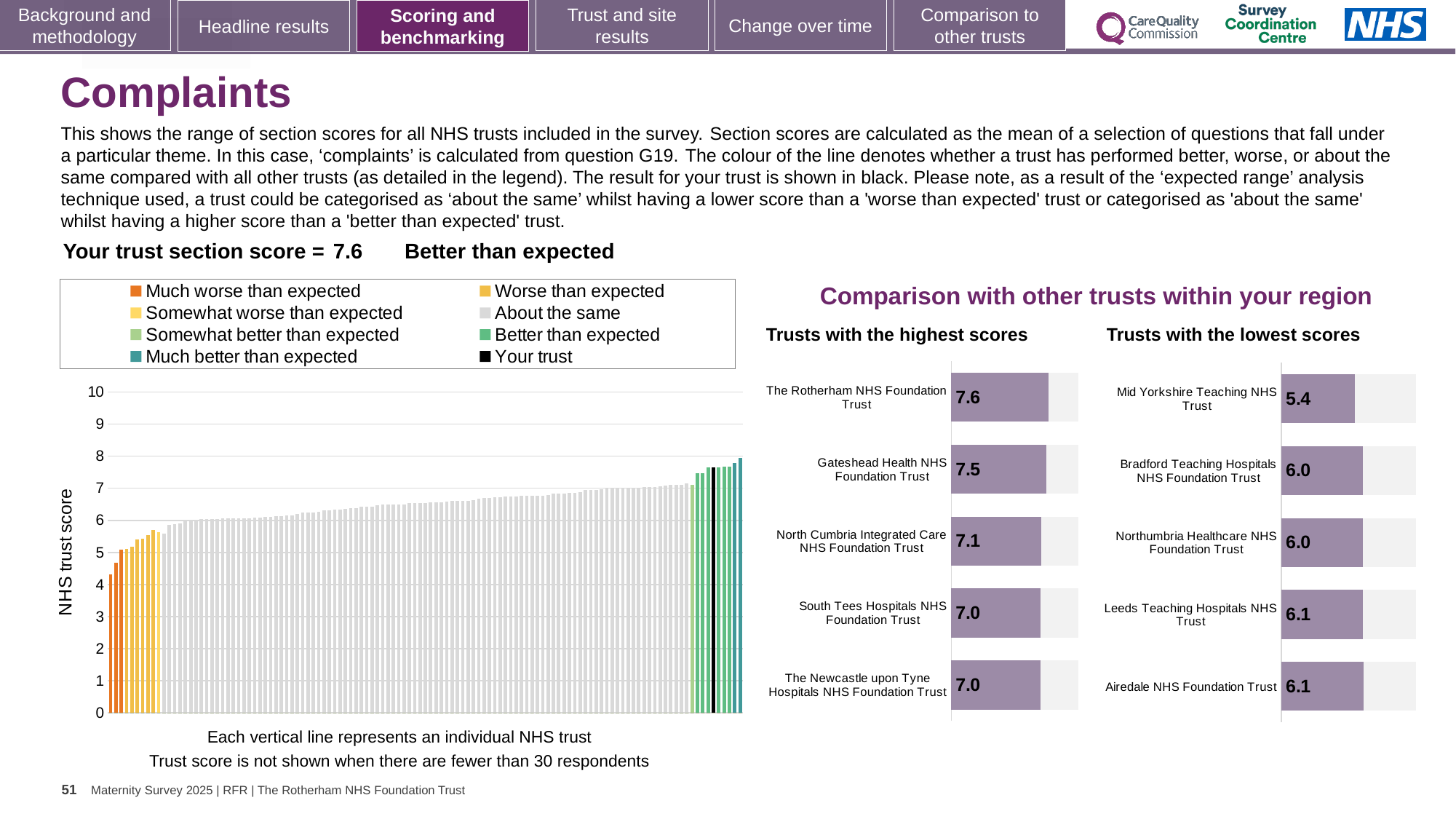
In the NHS trust score chart on the left, what colour is used for 'Your trust'? Black In the 'Trusts with the highest scores' chart, which has the larger score: Gateshead Health NHS Foundation Trust or North Cumbria Integrated Care NHS Foundation Trust? Gateshead Health NHS Foundation Trust In the 'Trusts with the lowest scores' chart, how many trusts are shown? 5 In the 'Trusts with the lowest scores' chart, which trust has the lowest score? Mid Yorkshire Teaching NHS Trust In the 'Trusts with the highest scores' chart, what is the difference between the scores of The Rotherham NHS Foundation Trust and Gateshead Health NHS Foundation Trust? 0.1 How many entries does the legend of the NHS trust score chart on the left list? 8 In the 'Trusts with the highest scores' chart, which trust has the highest score? The Rotherham NHS Foundation Trust In the 'Trusts with the lowest scores' chart, what is the difference between the scores of Airedale NHS Foundation Trust and Mid Yorkshire Teaching NHS Trust? 0.7 In the NHS trust score chart on the left, is the value of the lowest bar greater or less than 5? less In the 'Trusts with the highest scores' chart, what is the score for Gateshead Health NHS Foundation Trust? 7.5 In the 'Trusts with the lowest scores' chart, what is the score for Mid Yorkshire Teaching NHS Trust? 5.4 What kind of chart is the NHS trust score chart on the left of the slide? Bar chart